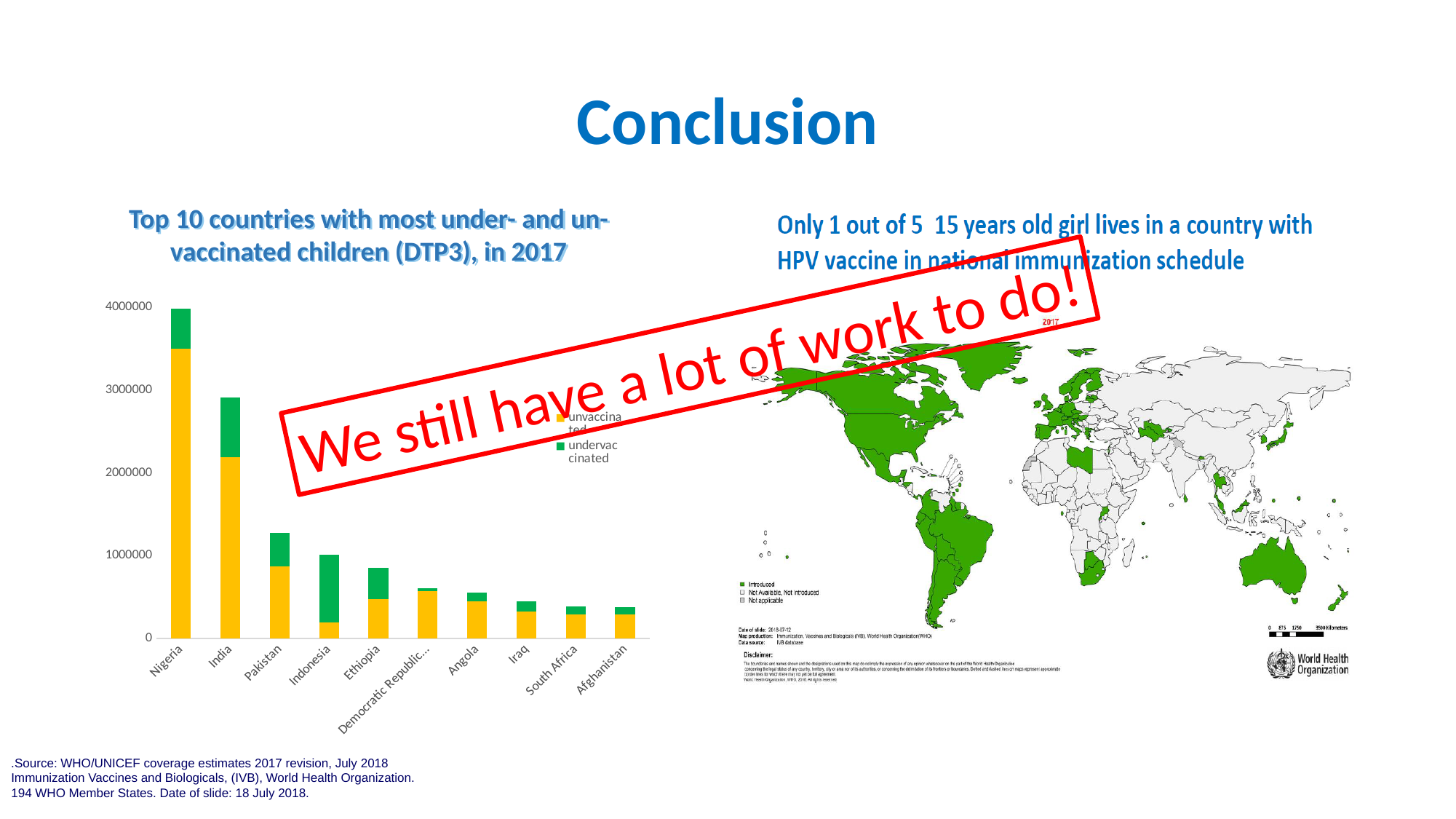
In the bar chart, is the total value for Pakistan greater or less than 1000000? greater In the bar chart, which has the larger total, Nigeria or India? Nigeria In the bar chart, do the total values rise or fall from left to right along the x axis? fall How many countries are shown on the x axis of the bar chart? 10 In the bar chart, which country has the highest total number of under- and un-vaccinated children? Nigeria In the bar chart, which colour represents the 'unvaccinated' series? Yellow In the bar chart, is the total value for Ethiopia greater or less than 1000000? less How many series does the legend of the bar chart list? 2 In the bar chart, for Indonesia, which segment is larger: unvaccinated or undervaccinated? undervaccinated What kind of chart is the 'Top 10 countries with most under- and un-vaccinated children (DTP3), in 2017' chart? Stacked bar chart In the bar chart, is the total value for India greater or less than 3000000? less